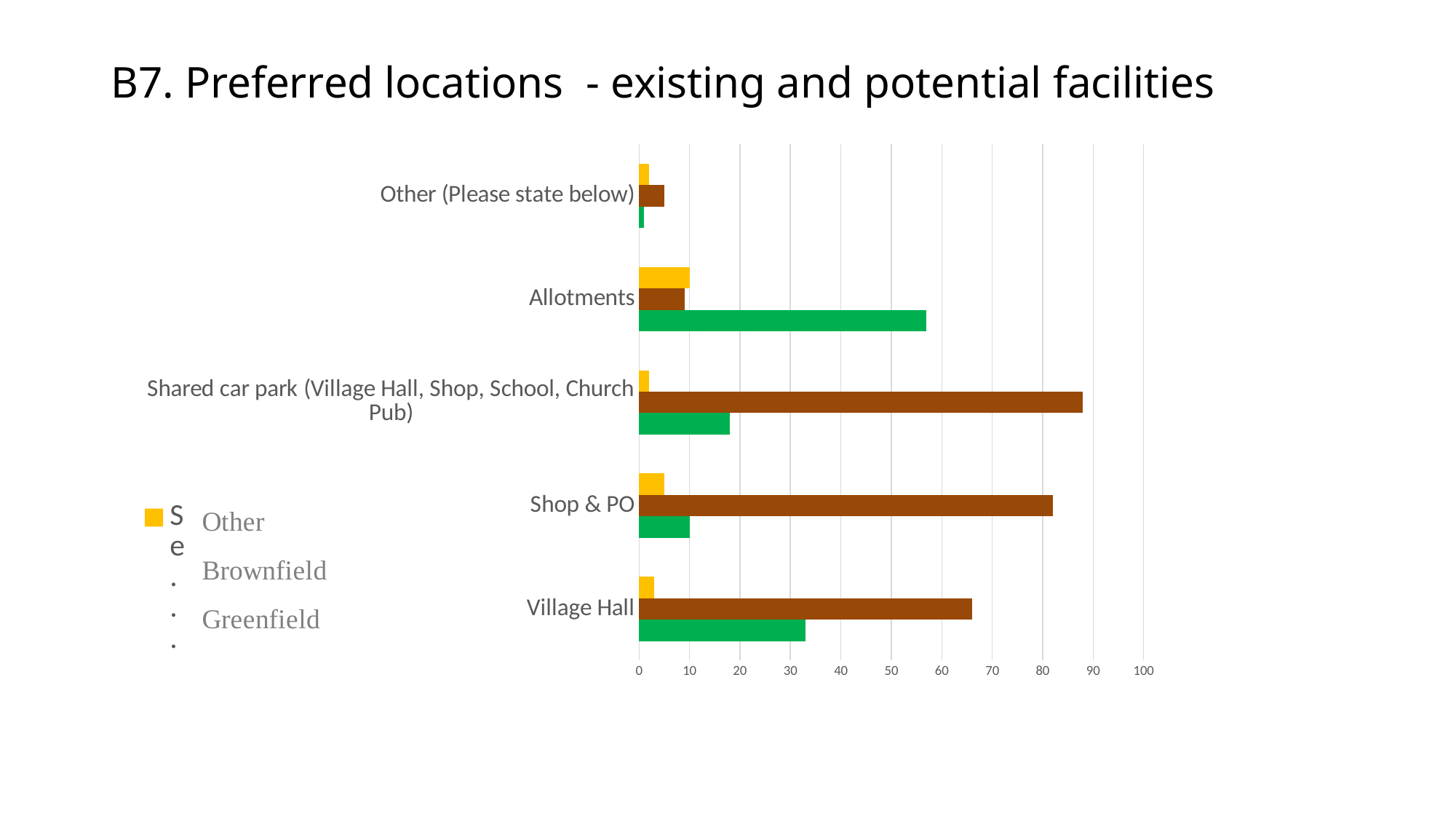
Which category has the longest Greenfield bar? Allotments For Village Hall, which is larger: the Brownfield value or the Greenfield value? Brownfield How many categories are plotted on the chart? 5 Which category has the shortest Brownfield bar? Other (Please state below) Which category has the longest Brownfield bar? Shared car park (Village Hall, Shop, School, Church Pub) For Allotments, which is larger: the Greenfield value or the Brownfield value? Greenfield Is the Greenfield value for Village Hall greater or less than 40? less What is the highest value shown on the horizontal axis? 100 What kind of chart is shown on the slide? bar chart How many series does the legend list? 3 Is the Brownfield value for Shop & PO greater or less than 80? greater Is the Greenfield value for Allotments greater or less than 50? greater